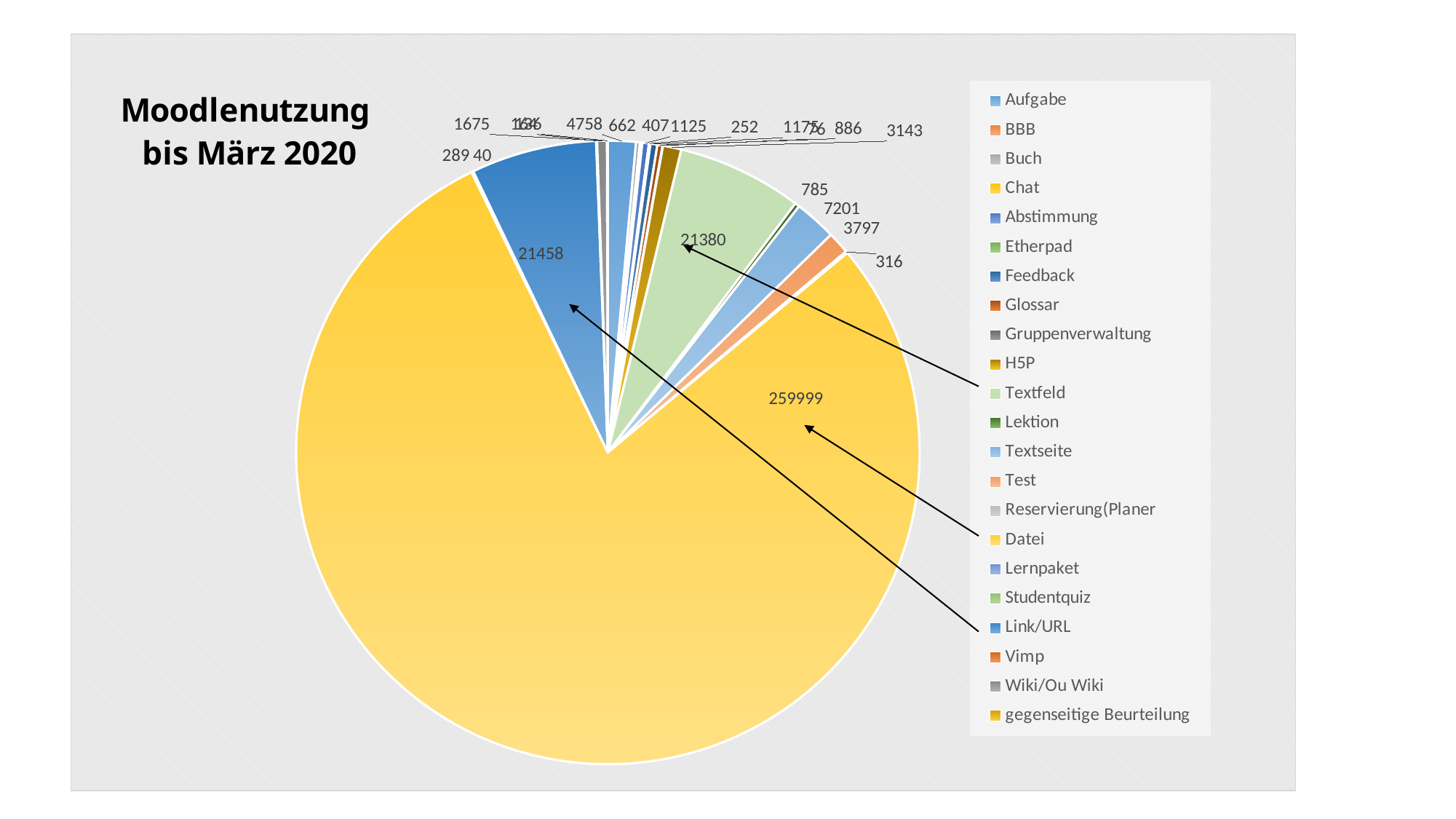
What is the difference between the values for Link/URL and Textfeld? 78 Which is larger, the value for Link/URL or the value for Textfeld? Link/URL What is the value for Textfeld? 21380 What kind of chart is shown on the slide? pie chart What is the title of the chart? Moodlenutzung bis März 2020 What is the value for Datei? 259999 How many entries does the chart legend list? 22 What is the difference between the values for Datei and Link/URL? 238541 Which is larger, the value for Datei or the value for Textfeld? Datei What is the value for Link/URL? 21458 Which category has the largest slice of the pie? Datei What is the value for Textseite? 7201